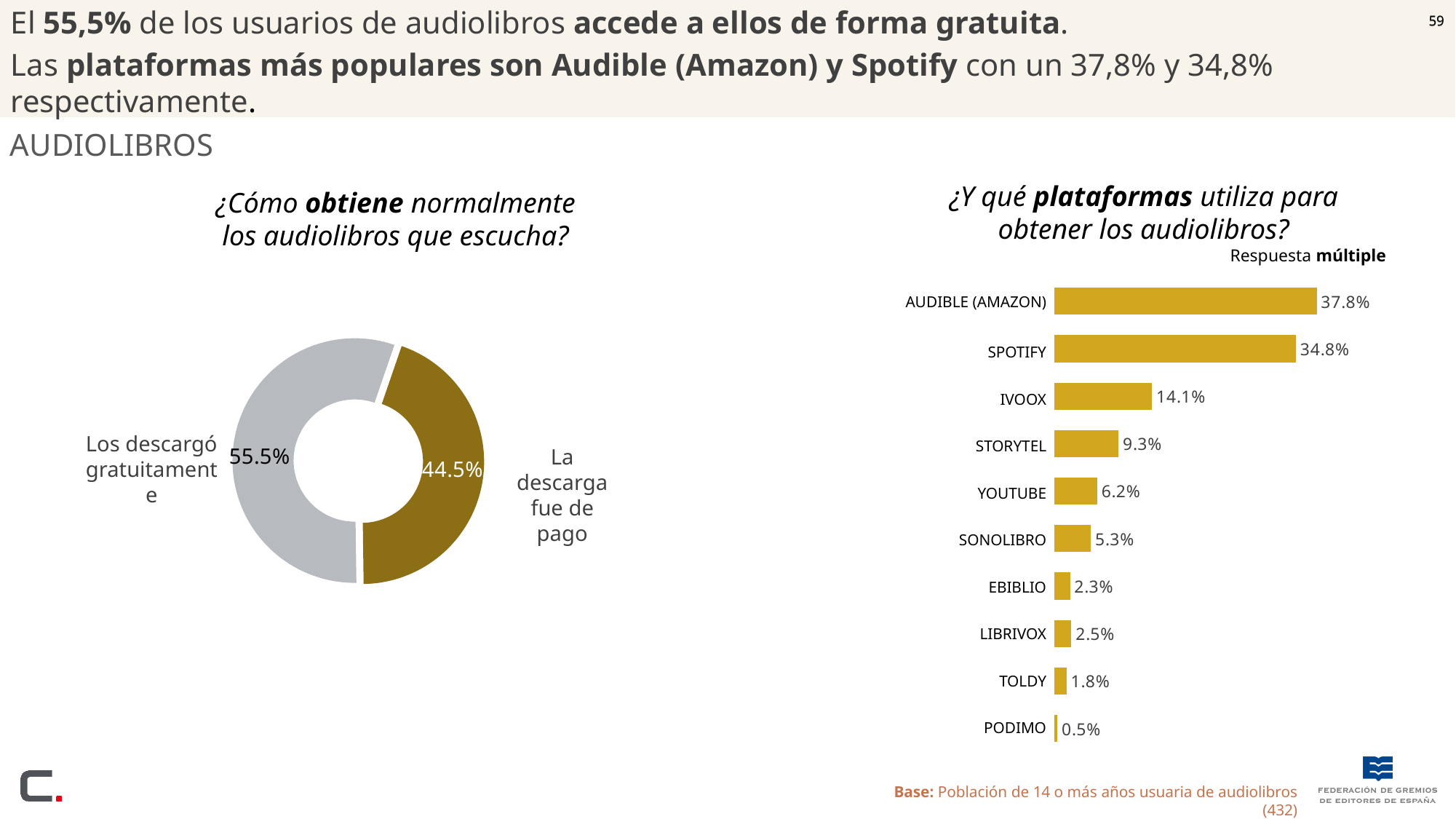
What kind of chart is '¿Cómo obtiene normalmente los audiolibros que escucha?'? Pie (doughnut) chart In the chart '¿Y qué plataformas utiliza para obtener los audiolibros?', what is the difference between AUDIBLE (AMAZON) and SPOTIFY? 3.0% In the chart '¿Y qué plataformas utiliza para obtener los audiolibros?', which platform has the lowest value? PODIMO In the chart '¿Cómo obtiene normalmente los audiolibros que escucha?', what share corresponds to 'Los descargó gratuitamente'? 55.5% In the chart '¿Y qué plataformas utiliza para obtener los audiolibros?', how many platforms are listed? 10 In the chart '¿Y qué plataformas utiliza para obtener los audiolibros?', what is the value for SPOTIFY? 34.8% In the chart '¿Y qué plataformas utiliza para obtener los audiolibros?', which platform has the highest value? AUDIBLE (AMAZON) What kind of chart is '¿Y qué plataformas utiliza para obtener los audiolibros?'? Bar chart In the chart '¿Y qué plataformas utiliza para obtener los audiolibros?', which is larger, STORYTEL or YOUTUBE? STORYTEL In the chart '¿Y qué plataformas utiliza para obtener los audiolibros?', what is the value for TOLDY? 1.8% In the chart '¿Cómo obtiene normalmente los audiolibros que escucha?', what share corresponds to 'La descarga fue de pago'? 44.5% In the chart '¿Y qué plataformas utiliza para obtener los audiolibros?', what is the value for IVOOX? 14.1%